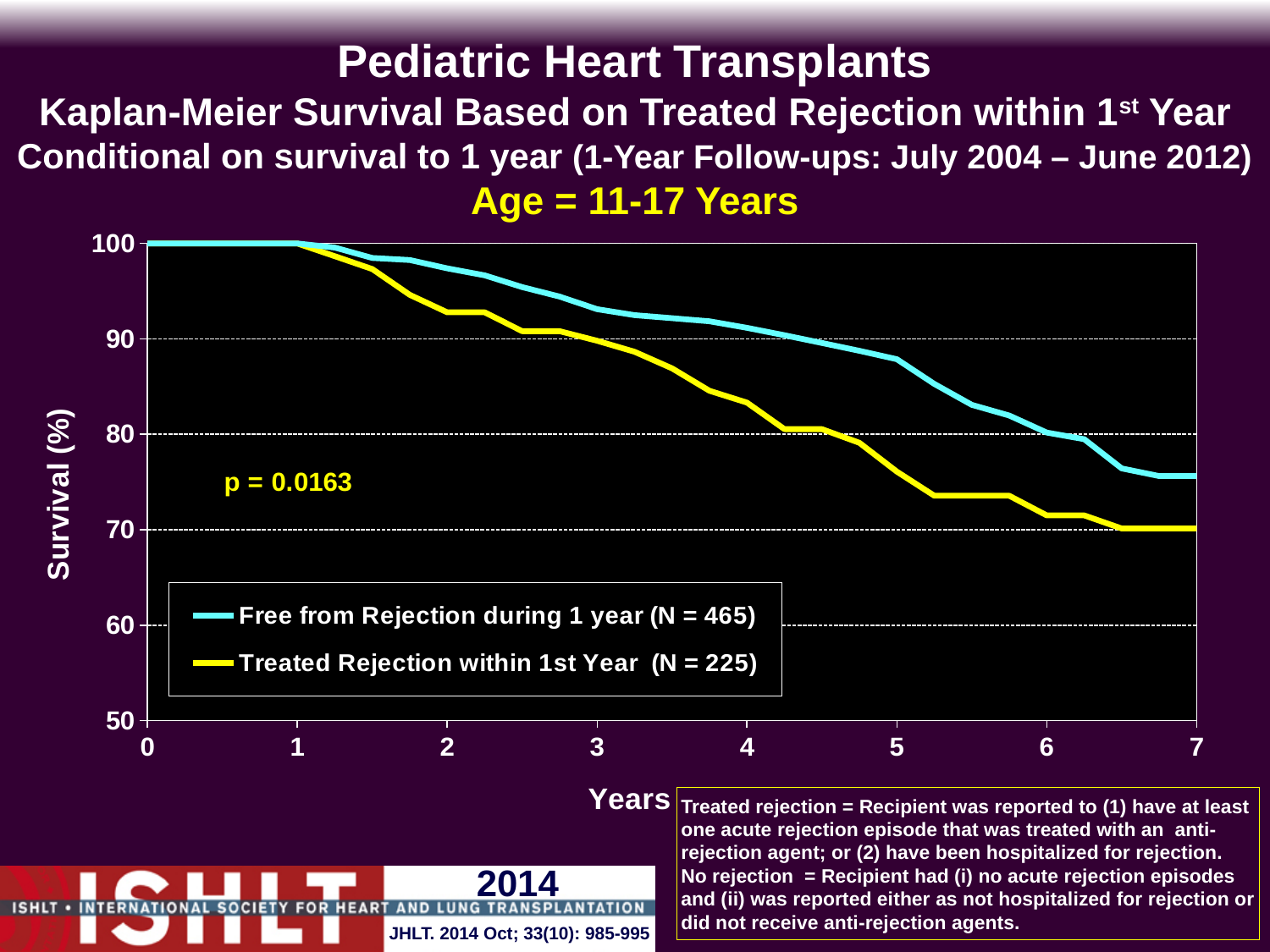
Is the survival value for the 'Free from Rejection during 1 year' group at year 7 greater or less than 70? greater What kind of chart is shown on the slide? line chart What is the N for the 'Treated Rejection within 1st Year' group in the legend? N = 225 Is the survival value for the 'Free from Rejection during 1 year' group at year 7 greater or less than 80? less How many series does the legend list? 2 Is the survival value for the 'Free from Rejection during 1 year' group at year 4 greater or less than 90? greater What p-value is shown on the chart? p = 0.0163 Do the survival curves rise or fall as years increase? fall At year 5, which group has the higher survival: 'Free from Rejection during 1 year' or 'Treated Rejection within 1st Year'? Free from Rejection during 1 year What is the survival (%) for both groups at year 0? 100